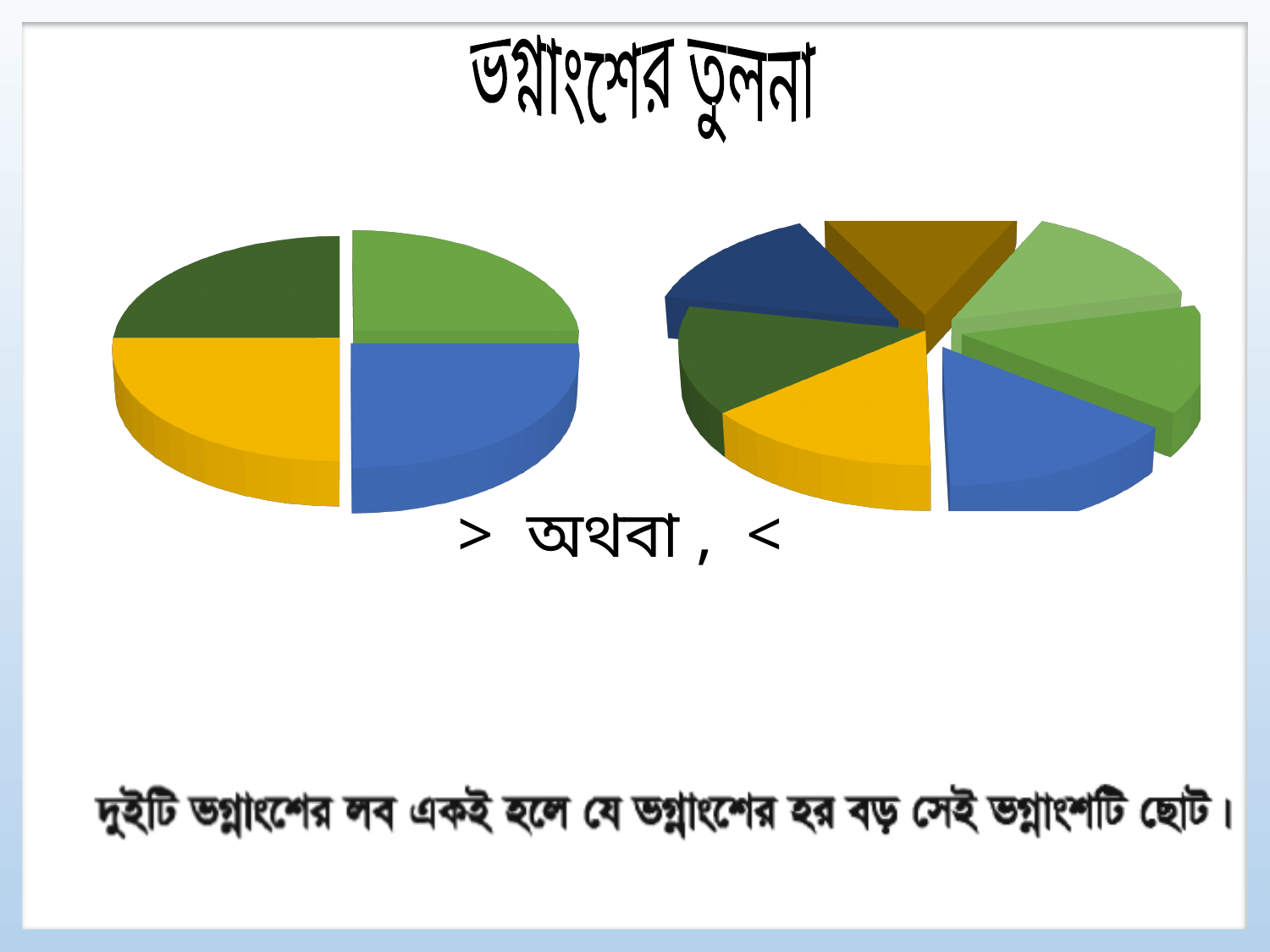
How many slices does the pie chart on the right side of the slide have? 7 What kind of chart is the chart on the left side of the slide? pie chart Are the slices of the pie chart on the right side of the slide pulled apart (exploded) or joined together? pulled apart Which pie chart has more slices, the one on the left or the one on the right? the one on the right How many slices does the pie chart on the left side of the slide have? 4 What kind of chart is the chart on the right side of the slide? pie chart Does either pie chart on the slide show a legend? No